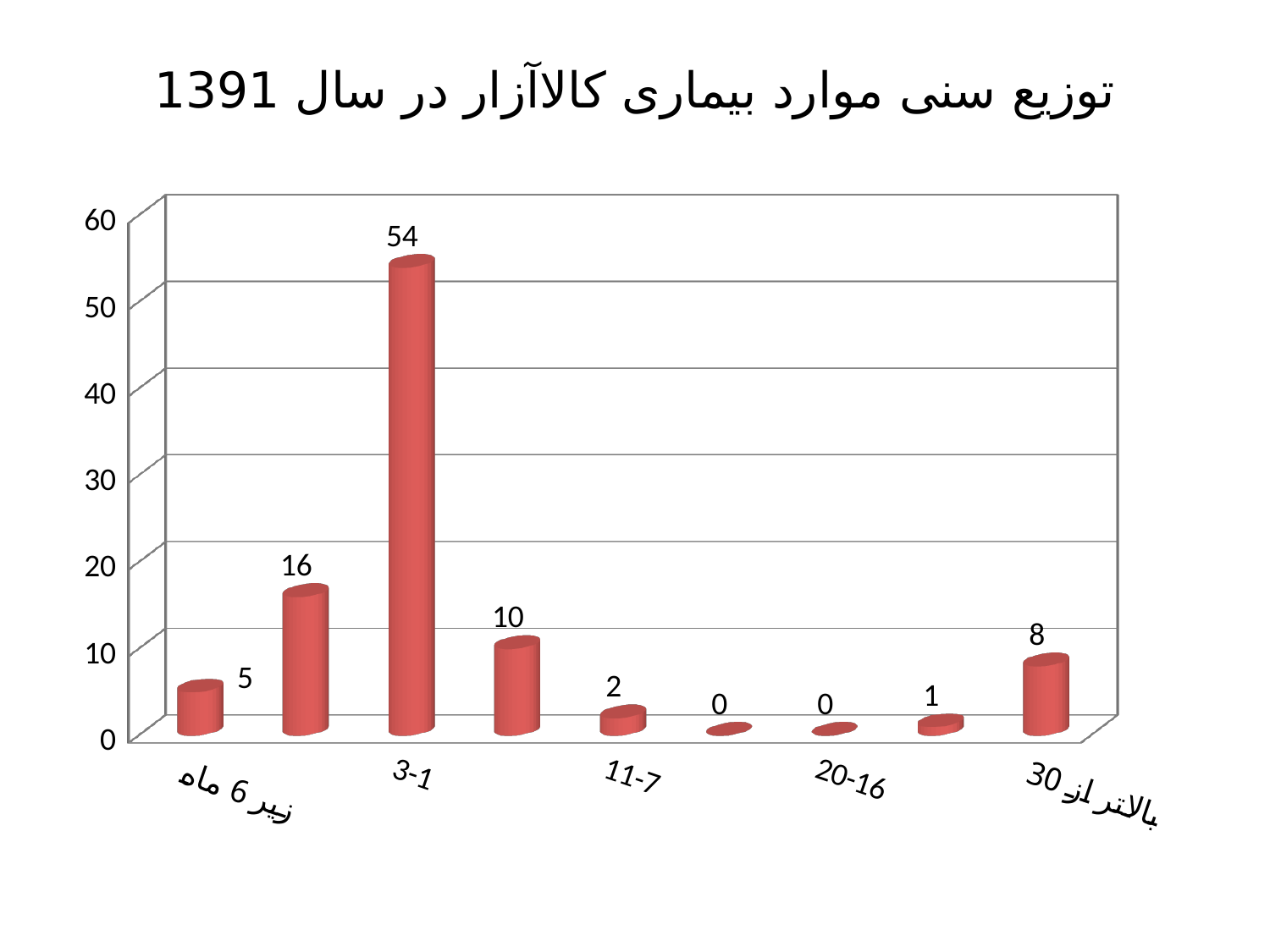
What kind of chart is shown on the slide? bar chart What is the difference between the value for 3-1 and the value for زیر 6 ماه? 49 What is the value for the 11-7 age group? 2 How many bars are plotted in the chart? 9 Is the value for 3-1 greater or less than 50? greater What year is mentioned in the chart title? 1391 Which age group has the highest value? 3-1 Which is larger, the value for بالاتر از 30 or the value for 11-7? بالاتر از 30 What is the value for the 3-1 age group? 54 What is the value for the 20-16 age group? 0 What is the value for the بالاتر از 30 (above 30) category? 8 What is the value for the زیر 6 ماه (under 6 months) category? 5